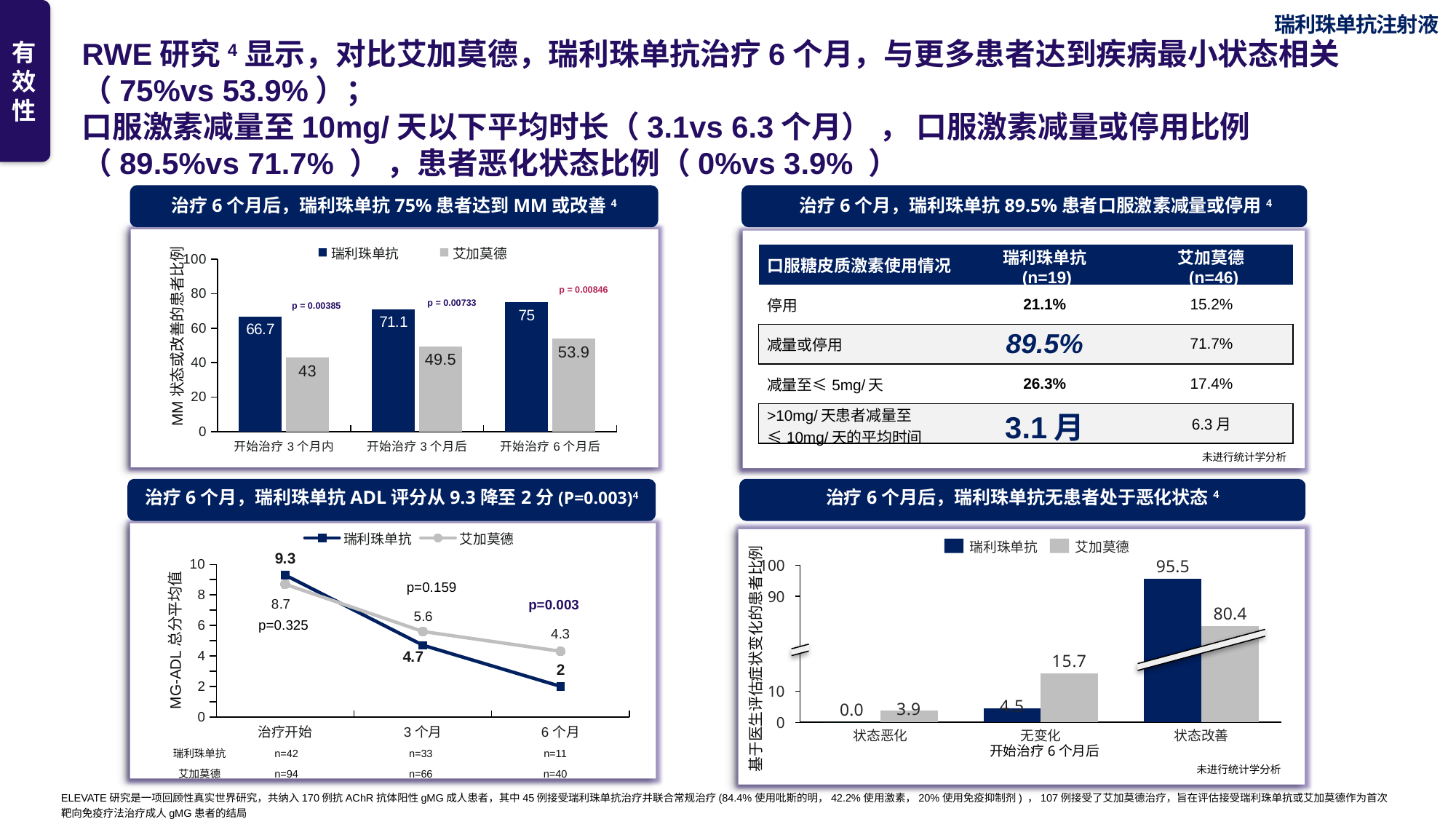
In the top-left bar chart (治疗6个月后，瑞利珠单抗75%患者达到MM或改善), what is the value for 瑞利珠单抗 at 开始治疗6个月后? 75 In the top-left bar chart, what is the value for 艾加莫德 at 开始治疗3个月内? 43 In the top-left bar chart, what is the difference between 瑞利珠单抗 and 艾加莫德 at 开始治疗3个月后? 21.6 In the bottom-right bar chart (治疗6个月后，瑞利珠单抗无患者处于恶化状态), what is the value for 艾加莫德 at 无变化? 15.7 In the bottom-left line chart, what is the value for 艾加莫德 at 3个月? 5.6 In the top-left bar chart, do the 瑞利珠单抗 values rise or fall from 开始治疗3个月内 to 开始治疗6个月后? rise In the bottom-right bar chart, which category has the highest value for 瑞利珠单抗? 状态改善 What kind of chart is the bottom-left chart showing MG-ADL 总分平均值? line chart In the top-left bar chart, how many series does the legend list? 2 In the bottom-left line chart, which series has the higher value at 治疗开始, 瑞利珠单抗 or 艾加莫德? 瑞利珠单抗 In the bottom-right bar chart, what is the difference between 瑞利珠单抗 and 艾加莫德 at 状态改善? 15.1 In the bottom-left line chart (MG-ADL 总分平均值), what is the value for 瑞利珠单抗 at 6个月? 2